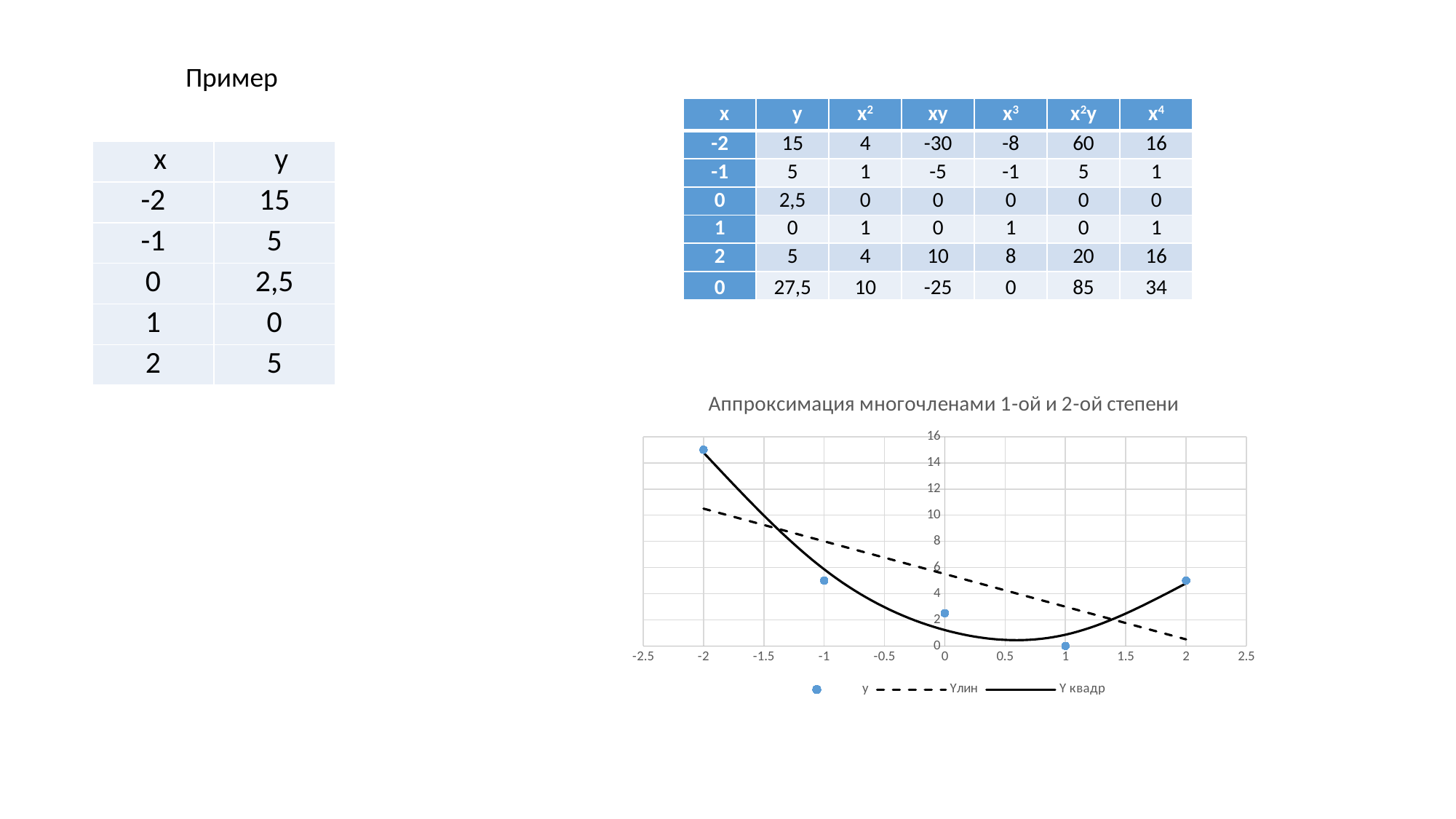
What is the value of the y point at x = 1? 0 What kind of chart is shown on the slide? scatter chart Is the value of the y point at x = 0 greater or less than 4? less Which y point is larger, the one at x = -2 or the one at x = 2? x = -2 Is the value of the y point at x = -1 greater or less than 6? less What is the title of the chart? Аппроксимация многочленами 1-ой и 2-ой степени Is the value of the y point at x = -2 greater or less than 14? greater At which x value is the plotted y point highest? -2 At which x value is the plotted y point lowest? 1 Does the dashed line Yлин rise or fall as x increases? fall How many series does the chart legend list? 3 How many data points are plotted for the series y? 5